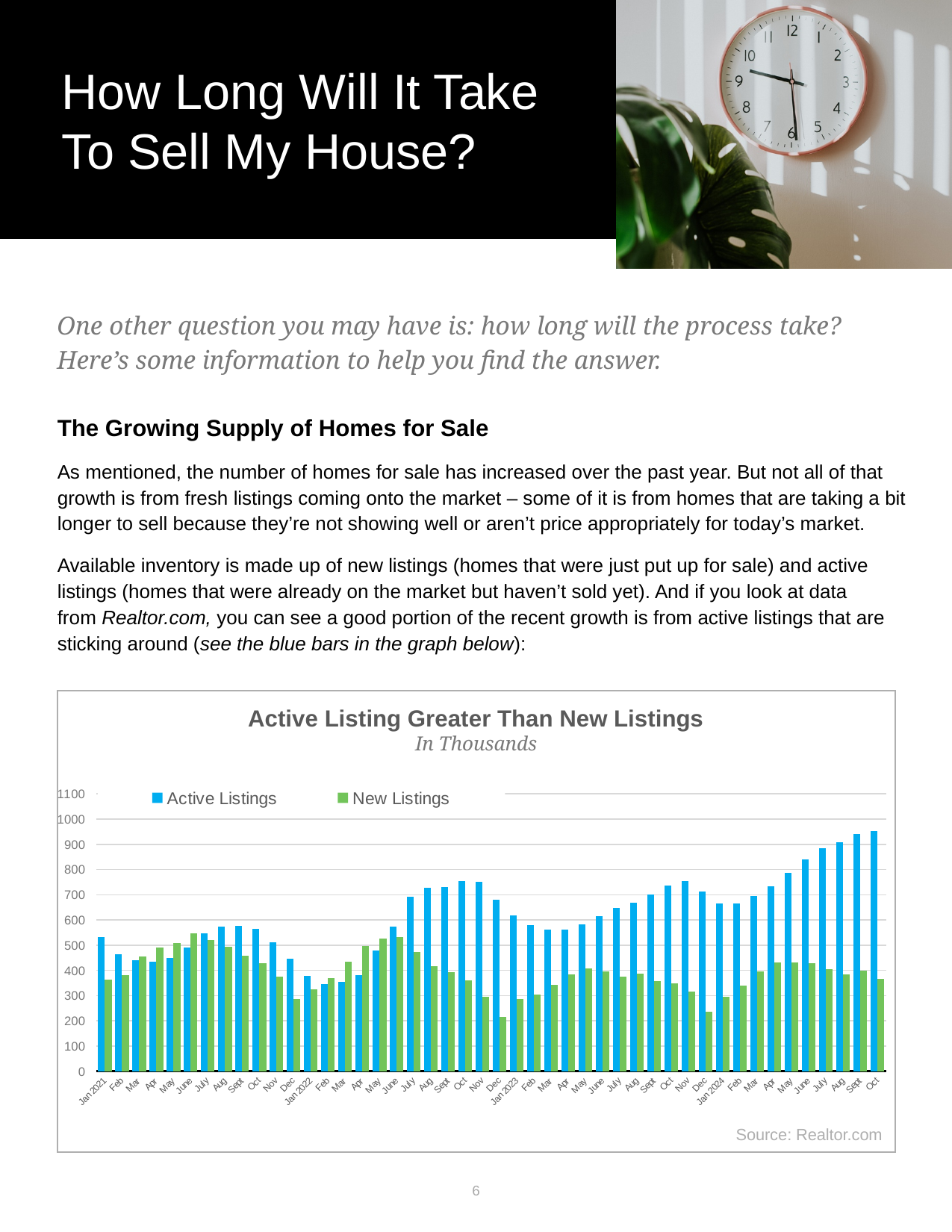
What type of chart is shown on the slide? bar chart Which series is shown in green in the chart? New Listings Is the Active Listings value for Feb 2022 greater or less than 400? less How many series does the chart legend list? 2 In June 2021, which is larger: Active Listings or New Listings? New Listings In which month is the Active Listings value highest? Oct 2024 Is the New Listings value for Dec 2022 greater or less than 300? less How many months are plotted along the x axis of the chart? 46 In which month is the New Listings value lowest? Dec 2022 Do Active Listings rise or fall from Jan 2024 to Oct 2024? rise Is the Active Listings value for Oct 2024 greater or less than 900? greater What is the title of the chart? Active Listing Greater Than New Listings